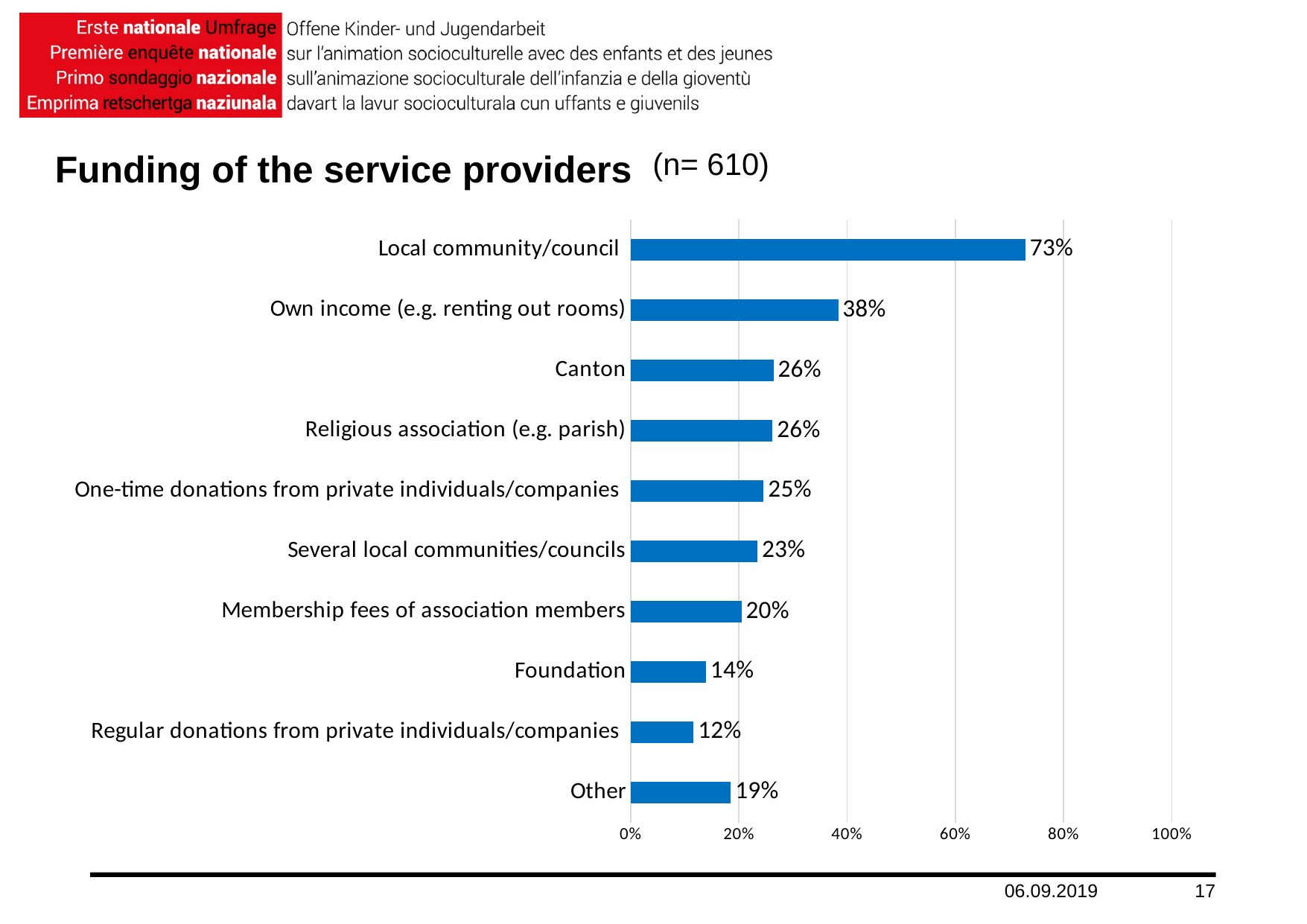
Which funding source has the highest value? Local community/council What is the value for Foundation? 14% Which is larger, Membership fees of association members or Other? Membership fees of association members Which funding source has the lowest value? Regular donations from private individuals/companies What is the difference between Local community/council and Own income (e.g. renting out rooms)? 35% What is the value for Own income (e.g. renting out rooms)? 38% Is the value for Several local communities/councils greater or less than 20%? greater What is the value for Canton? 26% What percentage of service providers are funded by the local community/council? 73% What kind of chart is shown on the slide? Bar chart How many funding sources are shown in the chart? 10 What is the sample size (n) given in the slide title? 610